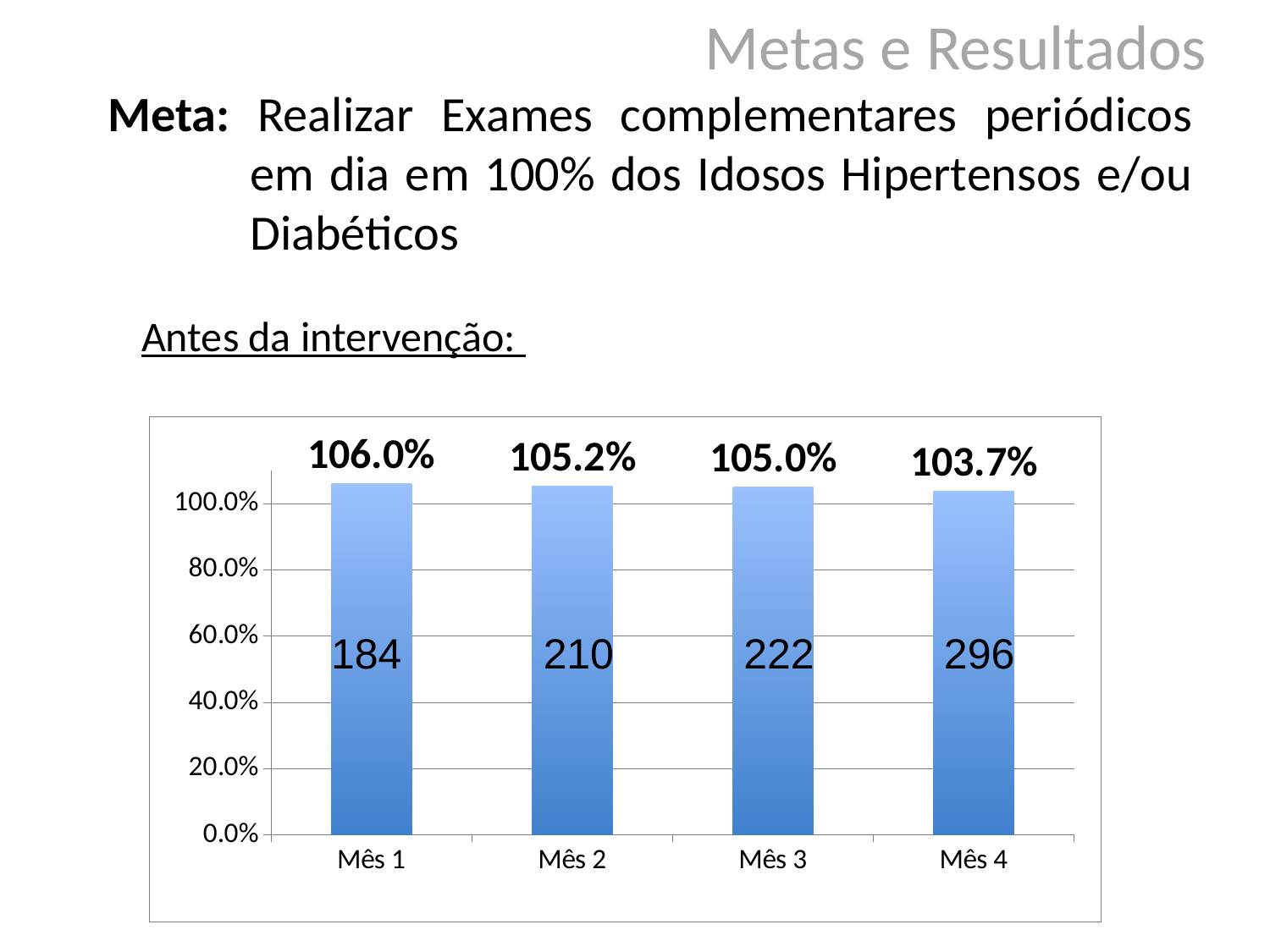
How many months (categories) are shown on the x axis? 4 What kind of chart is shown on the slide? Bar chart Which month has the highest percentage value? Mês 1 Do the percentage values rise or fall from Mês 1 to Mês 4? Fall What is the difference between the percentage for Mês 1 and the percentage for Mês 4? 2.3% What number is printed inside the bar for Mês 2? 210 What percentage is shown above the bar for Mês 1? 106.0% What number is printed inside the bar for Mês 3? 222 Which is larger, the percentage for Mês 2 or the percentage for Mês 3? Mês 2 What is the difference between the number inside the bar for Mês 4 and the number inside the bar for Mês 1? 112 What percentage is shown above the bar for Mês 4? 103.7% Which month has the lowest percentage value? Mês 4